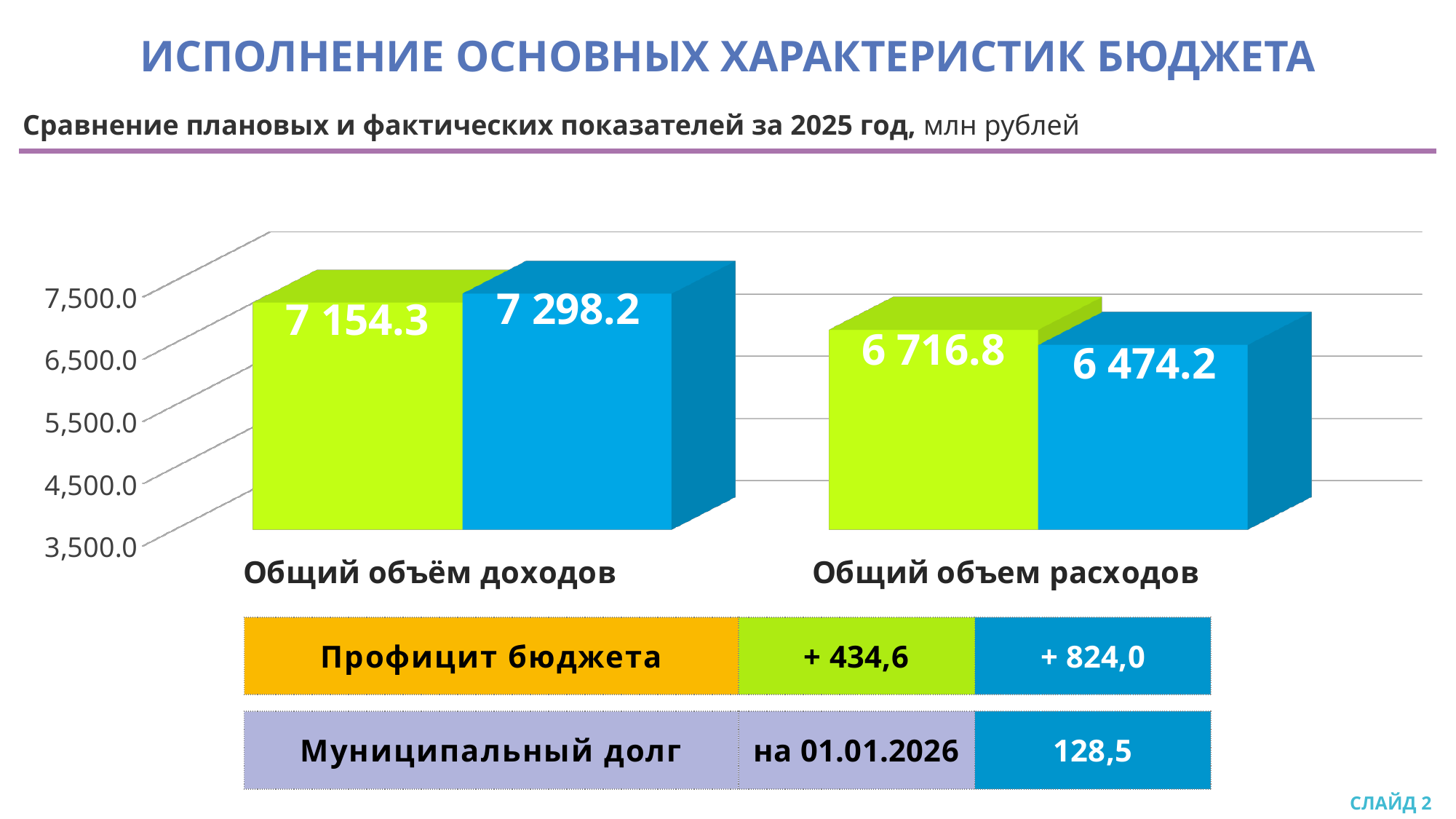
What type of chart is shown on the slide? bar chart Which bar has the highest value on the chart? the blue bar for «Общий объём доходов» (7 298.2) Which bar has the lowest value on the chart? the blue bar for «Общий объем расходов» (6 474.2) What is the value of the blue bar for «Общий объем расходов»? 6 474.2 For «Общий объем расходов», which bar is larger, the green or the blue one? green What is the difference between the green and blue bars for «Общий объем расходов»? 242.6 By how much does the blue bar exceed the green bar for «Общий объём доходов»? 143.9 For «Общий объём доходов», which bar is larger, the green or the blue one? blue How many categories are shown on the x axis of the chart? 2 What is the value of the green bar for «Общий объём доходов»? 7 154.3 What is the value of the green bar for «Общий объем расходов»? 6 716.8 What is the value of the blue bar for «Общий объём доходов»? 7 298.2